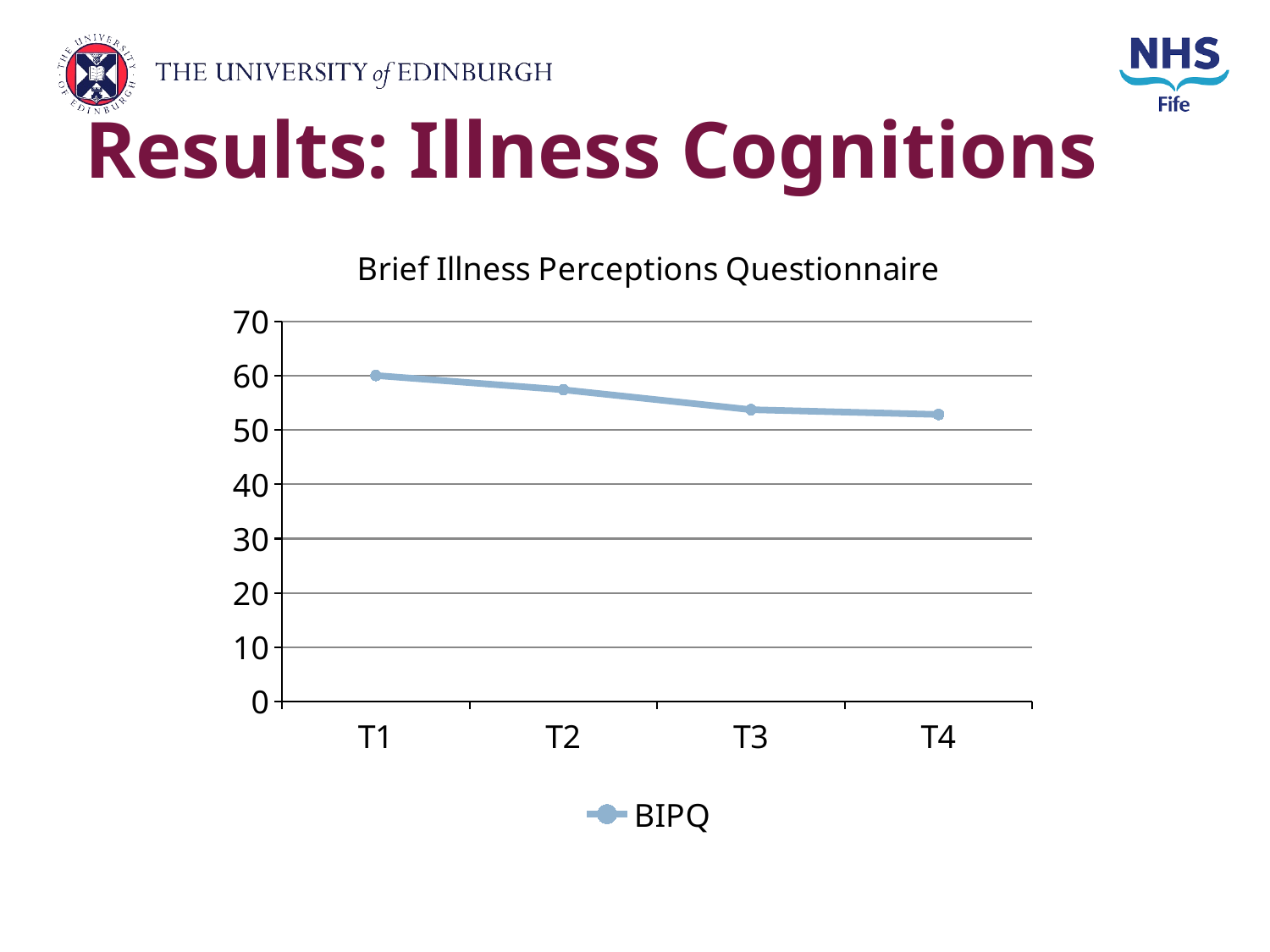
How many time points are plotted along the x axis? 4 How many series does the legend list? 1 What is the title of the chart? Brief Illness Perceptions Questionnaire What kind of chart is shown on the slide? line chart Which has the larger BIPQ value, T2 or T4? T2 Which has the larger BIPQ value, T1 or T3? T1 Is the BIPQ value at T4 greater or less than 50? greater What is the name of the series shown in the legend? BIPQ At which time point is the BIPQ value highest? T1 Do the BIPQ values rise or fall from T1 to T4? fall Is the BIPQ value at T1 greater or less than 50? greater Is the BIPQ value at T2 greater or less than 60? less